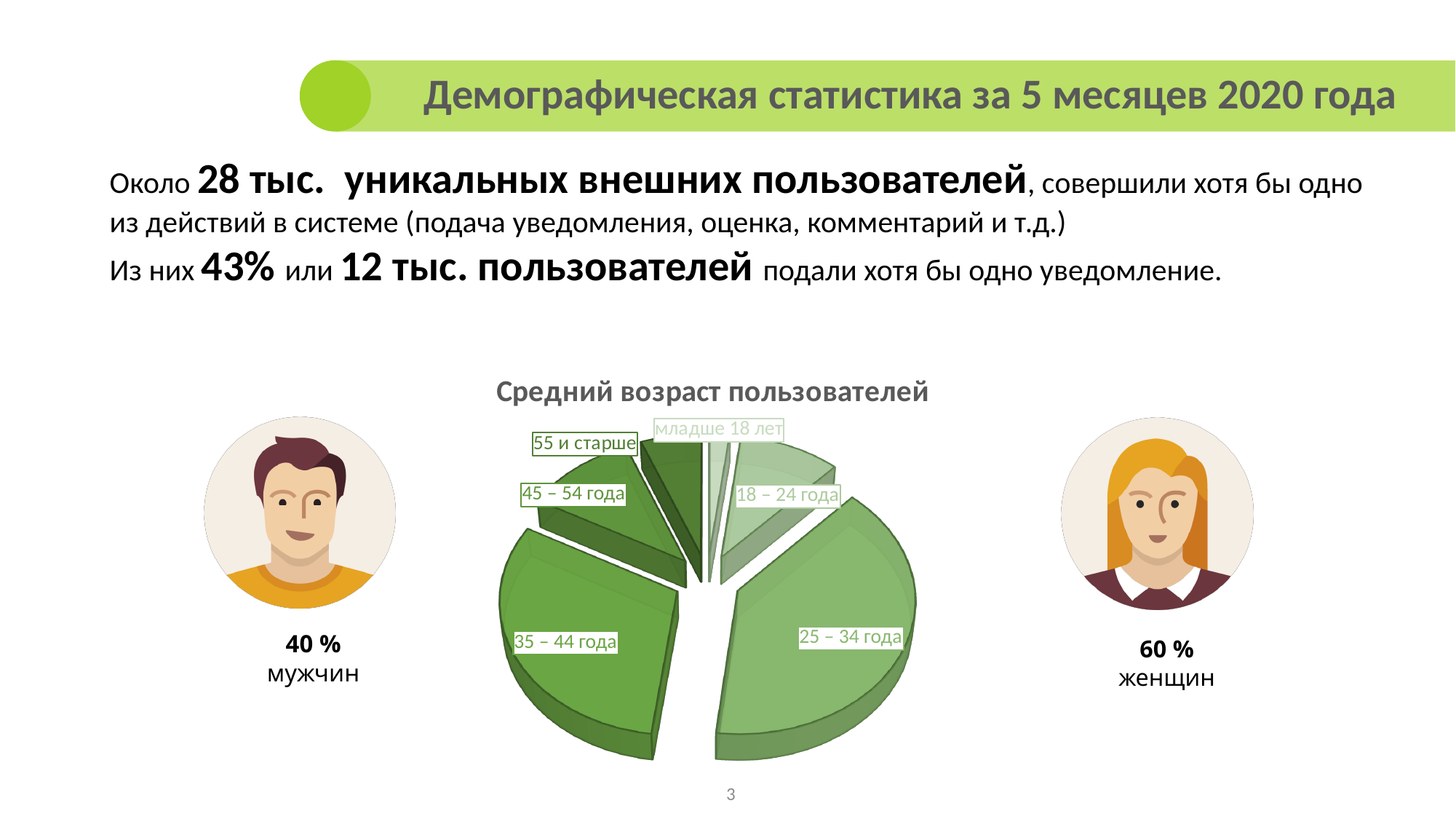
How many age categories does the pie chart show? 6 Which age category label appears at the top of the pie chart? младше 18 лет What kind of chart is shown under the title "Средний возраст пользователей"? pie chart In the pie chart, which slice is larger: "55 и старше" or "младше 18 лет"? 55 и старше In the pie chart, which slice is larger: "35 – 44 года" or "45 – 54 года"? 35 – 44 года In the pie chart, which slice is larger: "25 – 34 года" or "18 – 24 года"? 25 – 34 года Which age category has the smallest slice in the pie chart? младше 18 лет What is the title of the pie chart on the slide? Средний возраст пользователей